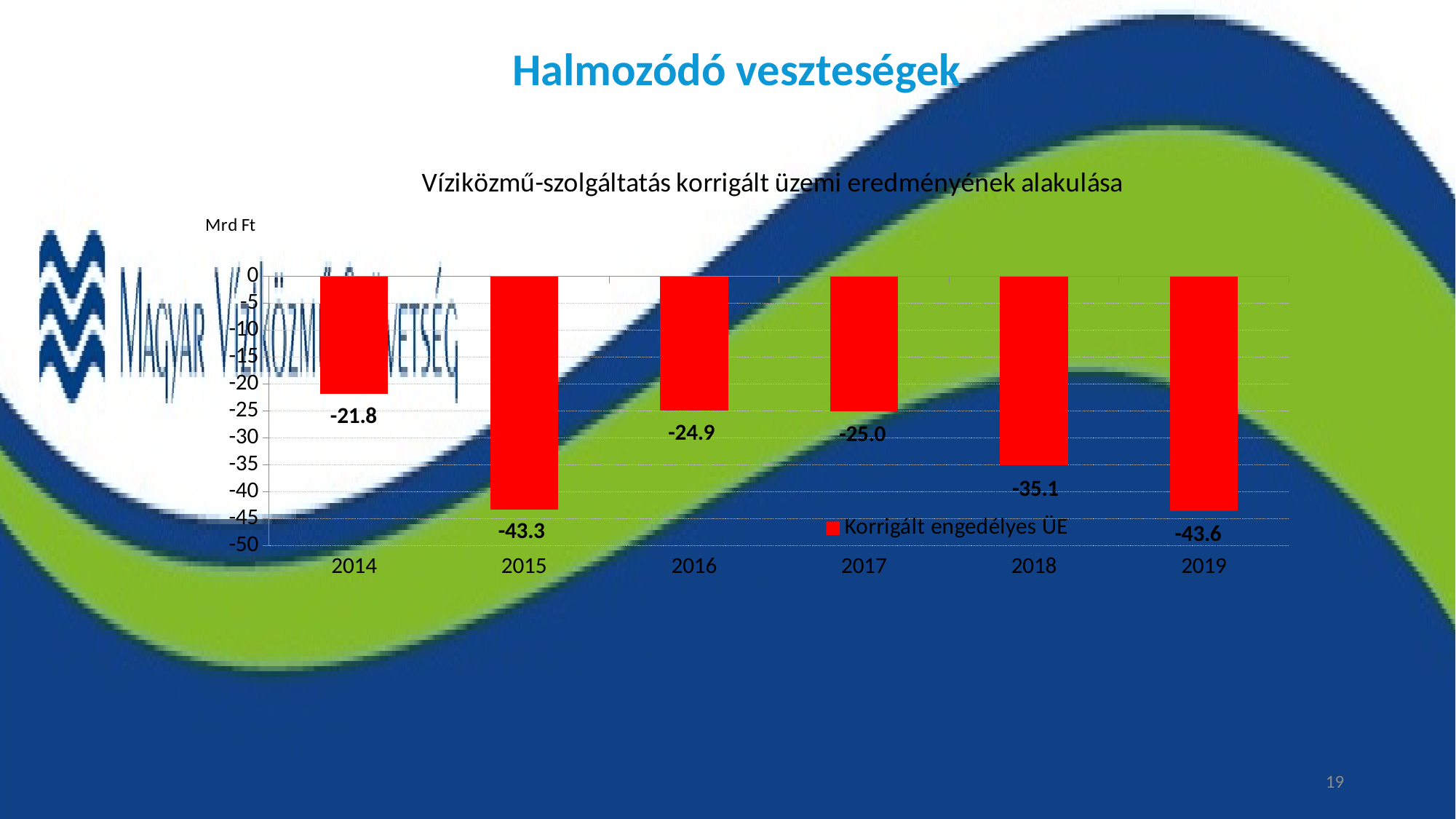
What is the value for 2019? -43.6 What is the value for 2014? -21.8 What is the value for 2018? -35.1 How many years are shown on the x axis? 6 Which year has the lowest value? 2019 Which is larger, the value for 2014 or the value for 2018? 2014 What kind of chart is shown on the slide? bar chart What is the difference between the values for 2014 and 2019? 21.8 Which year has the highest (least negative) value? 2014 What is the difference between the values for 2017 and 2018? 10.1 Is the value for 2018 greater or less than -30? less What is the value for 2015? -43.3